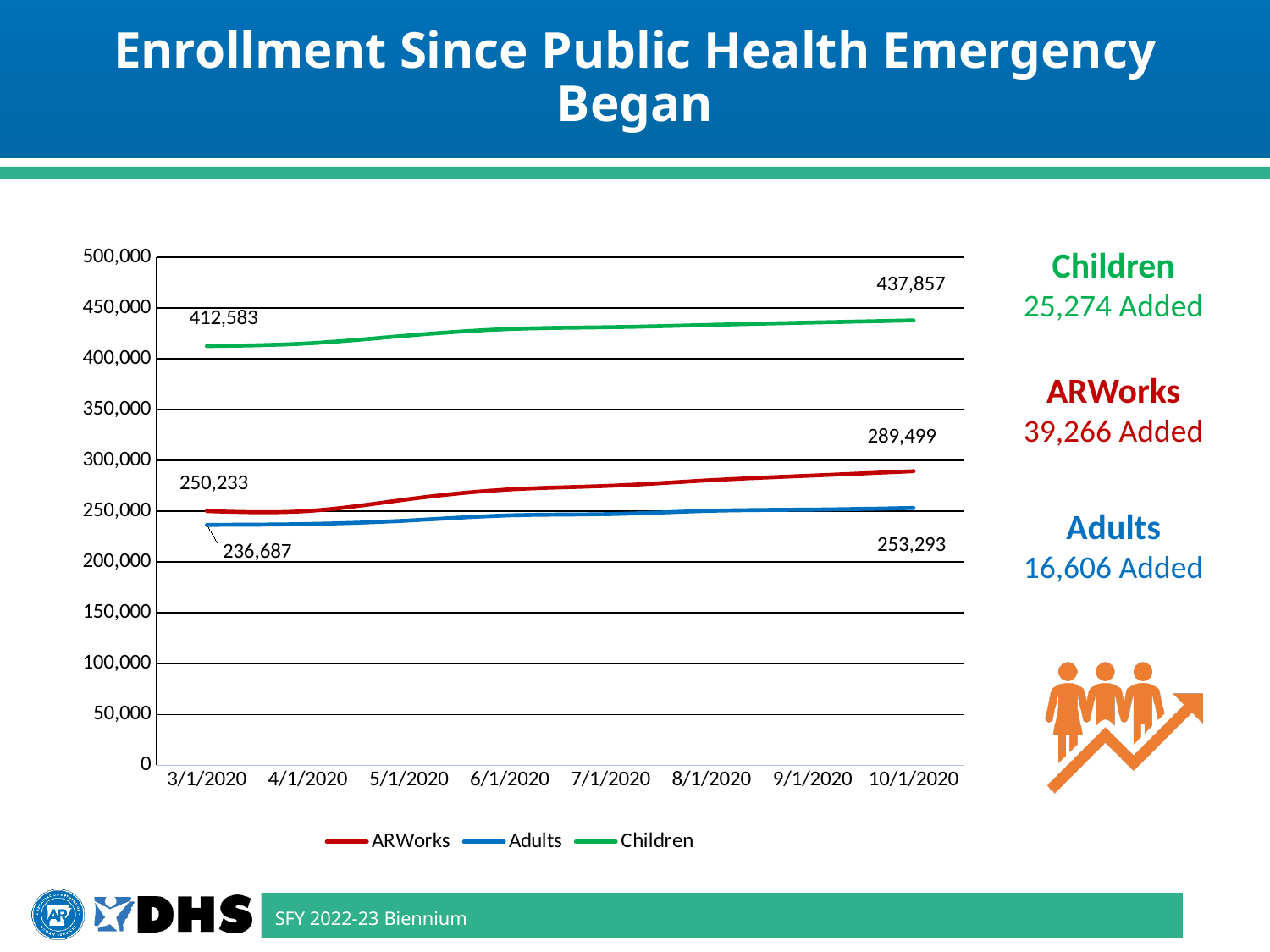
What is the ARWorks enrollment value shown for 10/1/2020? 289,499 Is the Children enrollment value for 6/1/2020 greater or less than 400,000? greater How many series does the legend list? 3 Which series has the highest enrollment on 10/1/2020? Children What is the Children enrollment value shown for 3/1/2020? 412,583 Which series has the lowest enrollment on 3/1/2020? Adults On 10/1/2020, which is larger: ARWorks enrollment or Adults enrollment? ARWorks What is the Children enrollment value shown for 10/1/2020? 437,857 By how much did ARWorks enrollment increase from 3/1/2020 to 10/1/2020? 39,266 What is the Adults enrollment value shown for 3/1/2020? 236,687 What kind of chart is shown on the slide? Line chart By how much did Adults enrollment increase from 3/1/2020 to 10/1/2020? 16,606